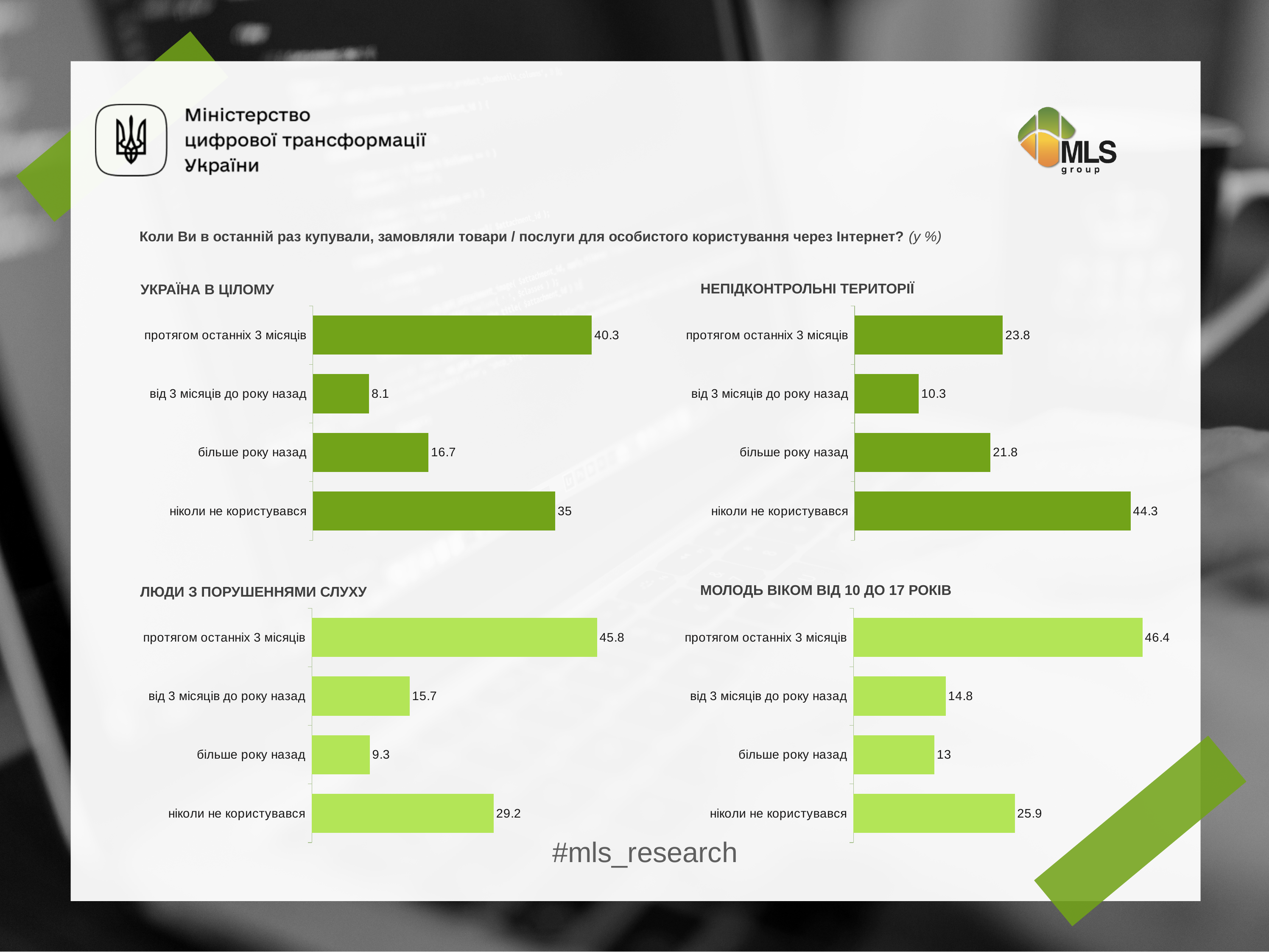
In the 'НЕПІДКОНТРОЛЬНІ ТЕРИТОРІЇ' chart, which category has the highest value? ніколи не користувався What type of chart is the 'УКРАЇНА В ЦІЛОМУ' chart? Bar chart In the 'ЛЮДИ З ПОРУШЕННЯМИ СЛУХУ' chart, what is the value for 'більше року назад'? 9.3 In the 'МОЛОДЬ ВІКОМ ВІД 10 ДО 17 РОКІВ' chart, what is the value for 'від 3 місяців до року назад'? 14.8 In the 'УКРАЇНА В ЦІЛОМУ' chart, which category has the lowest value? від 3 місяців до року назад In the 'ЛЮДИ З ПОРУШЕННЯМИ СЛУХУ' chart, what is the difference between 'протягом останніх 3 місяців' and 'ніколи не користувався'? 16.6 In the 'НЕПІДКОНТРОЛЬНІ ТЕРИТОРІЇ' chart, which is larger: 'протягом останніх 3 місяців' or 'більше року назад'? протягом останніх 3 місяців How many categories does the 'МОЛОДЬ ВІКОМ ВІД 10 ДО 17 РОКІВ' chart show? 4 In the 'УКРАЇНА В ЦІЛОМУ' chart, what is the difference between 'протягом останніх 3 місяців' and 'ніколи не користувався'? 5.3 In the 'НЕПІДКОНТРОЛЬНІ ТЕРИТОРІЇ' chart, what is the value for 'ніколи не користувався'? 44.3 In the 'МОЛОДЬ ВІКОМ ВІД 10 ДО 17 РОКІВ' chart, which category has the highest value? протягом останніх 3 місяців In the 'УКРАЇНА В ЦІЛОМУ' chart, what is the value for 'протягом останніх 3 місяців'? 40.3